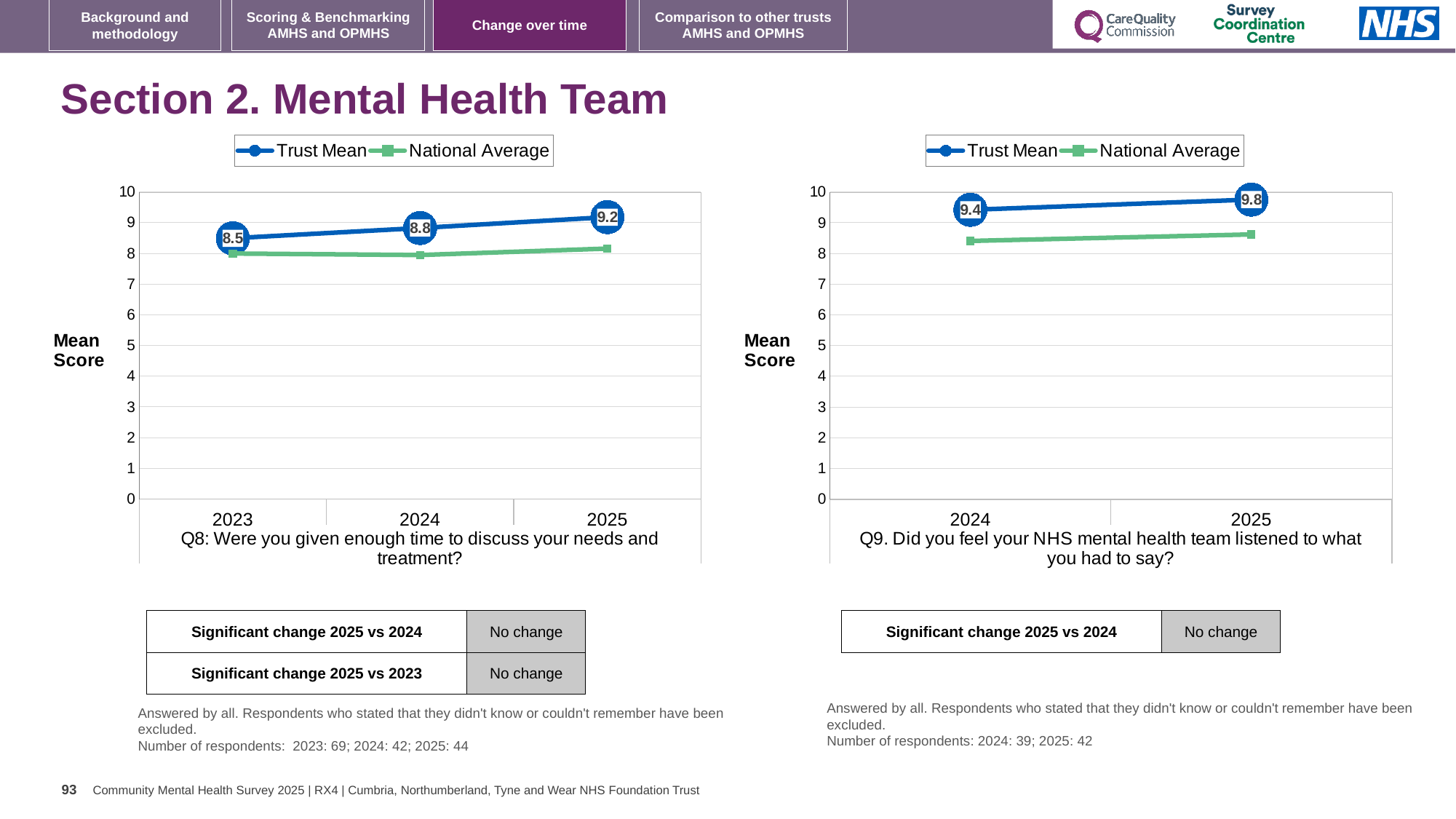
In the Q8 chart (left), what is the Trust Mean for 2025? 9.2 In the Q9 chart (right), what is the Trust Mean for 2025? 9.8 In the Q8 chart (left), which year has the lowest Trust Mean? 2023 In the Q8 chart (left), what is the difference between the Trust Mean in 2025 and in 2023? 0.7 In the Q8 chart (left), does the Trust Mean rise or fall from 2023 to 2025? rise What type of chart is the Q9 chart (right)? line chart In the Q9 chart (right), what is the difference between the Trust Mean in 2025 and in 2024? 0.4 In the Q9 chart (right), is the National Average for 2024 greater or less than 9? less In the Q9 chart (right), what is the Trust Mean for 2024? 9.4 In the Q8 chart (left), what is the Trust Mean for 2023? 8.5 In the Q8 chart (left), which year has the highest Trust Mean? 2025 How many years are plotted on the x axis of the Q8 chart (left)? 3